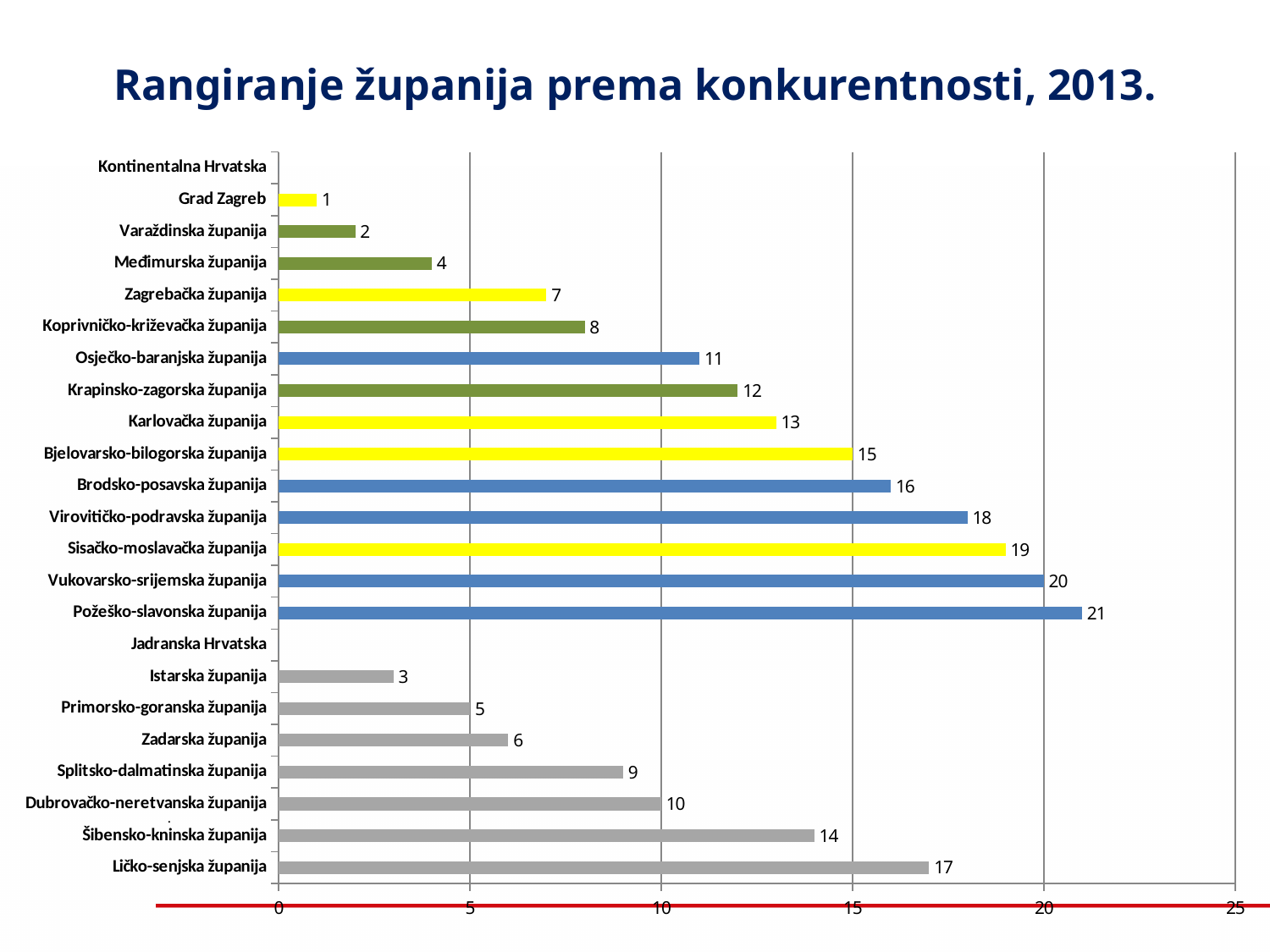
What is the difference between the values for Vukovarsko-srijemska županija and Osječko-baranjska županija? 9 What is the value shown for Požeško-slavonska županija? 21 What kind of chart is shown on the slide? Bar chart Is the value for Sisačko-moslavačka županija greater or less than 15? greater How many counties have a bar plotted on the chart? 21 Which county has the highest value on the chart? Požeško-slavonska županija Which has the larger value, Karlovačka županija or Šibensko-kninska županija? Šibensko-kninska županija What is the value shown for Ličko-senjska županija? 17 Which county has the lowest value on the chart? Grad Zagreb What is the value shown for Zagrebačka županija? 7 What is the title of the chart? Rangiranje županija prema konkurentnosti, 2013. What is the difference between the values for Ličko-senjska županija and Istarska županija? 14